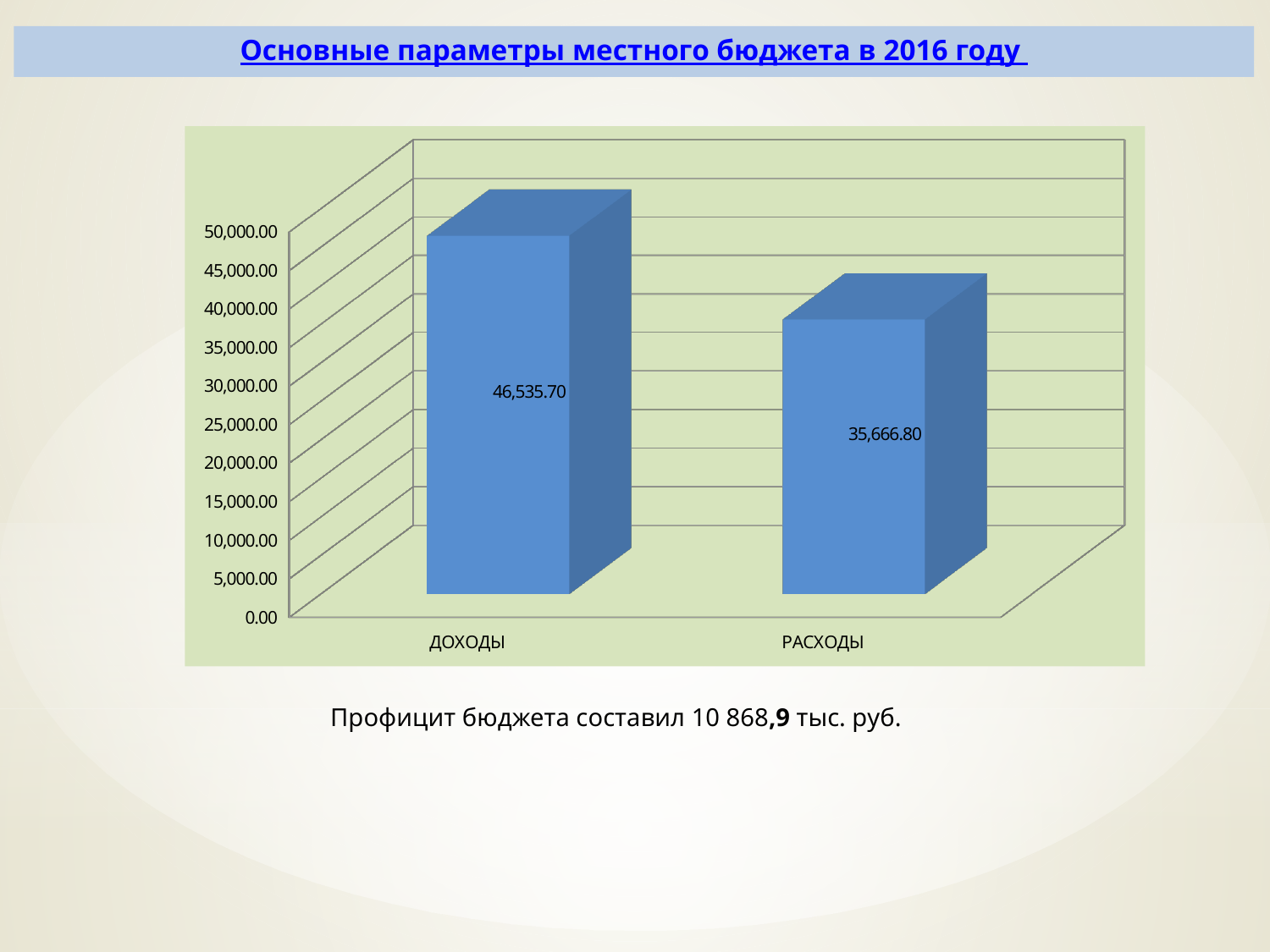
What is the value for РАСХОДЫ? 35,666.80 What is the value for ДОХОДЫ? 46,535.70 How many categories are shown on the x axis? 2 Which category has the highest value? ДОХОДЫ Which is larger, the value for ДОХОДЫ or the value for РАСХОДЫ? ДОХОДЫ What is the highest value labelled on the vertical axis? 50,000.00 What is the title of the slide above the chart? Основные параметры местного бюджета в 2016 году What is the difference between the values for ДОХОДЫ and РАСХОДЫ? 10,868.90 Is the value for ДОХОДЫ greater or less than 45,000.00? greater Is the value for РАСХОДЫ greater or less than 40,000.00? less What kind of chart is shown on the slide? bar chart Which category has the lowest value? РАСХОДЫ